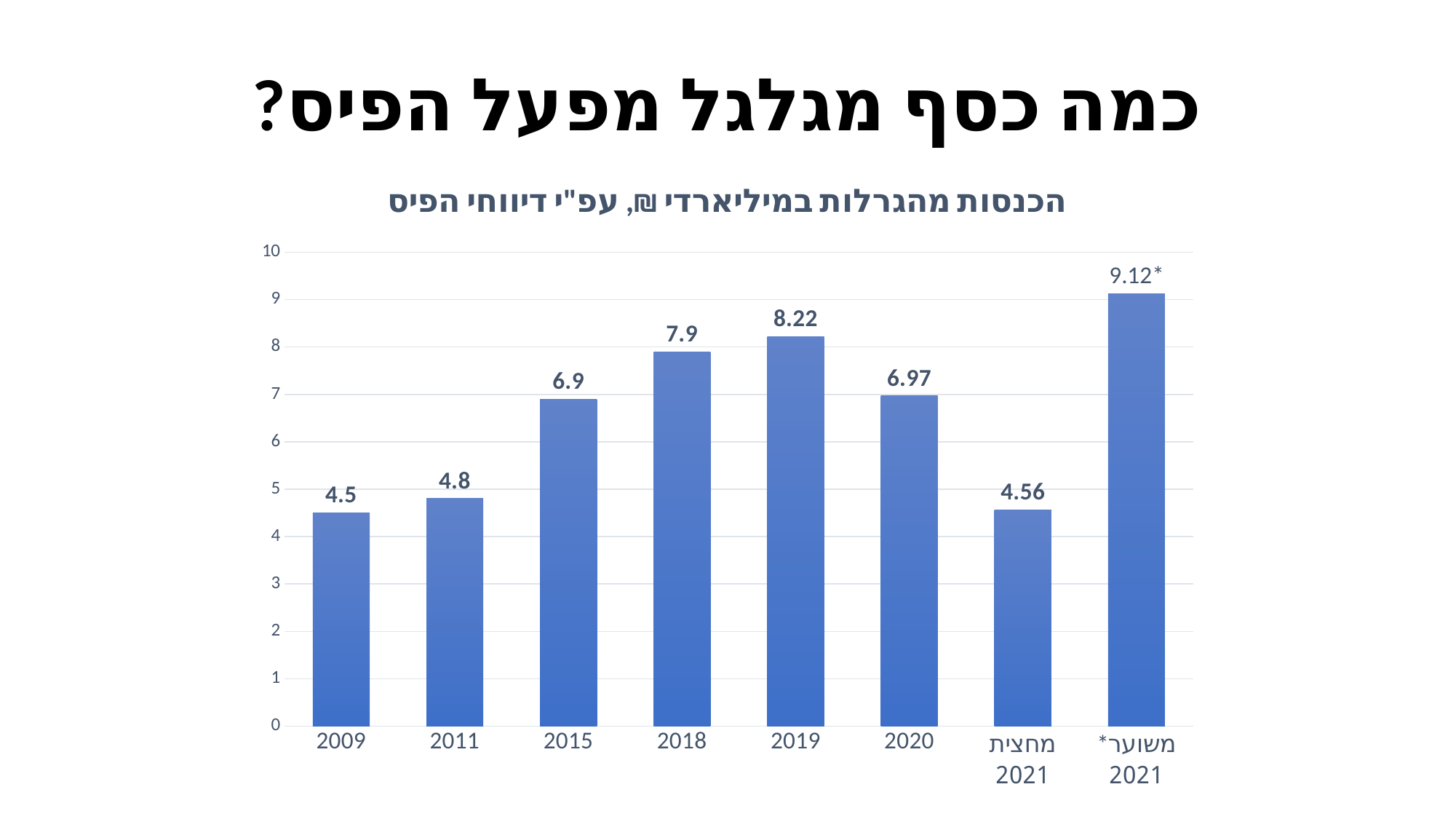
Which is larger, the value for 2015 or the value for 2020? 2020 What is the chart's subtitle text above the plot area? הכנסות מהגרלות במיליארדי ₪, עפ"י דיווחי הפיס Which category has the highest value? משוער* 2021 What is the value shown for מחצית 2021? 4.56 What is the difference between the values for 2020 and מחצית 2021? 2.41 What is the difference between the values for 2019 and 2018? 0.32 What is the value shown for 2009? 4.5 How many bars are shown in the chart? 8 What is the value shown for 2020? 6.97 What kind of chart is shown on the slide? Bar chart Which category has the lowest value? 2009 What is the value shown for 2019? 8.22